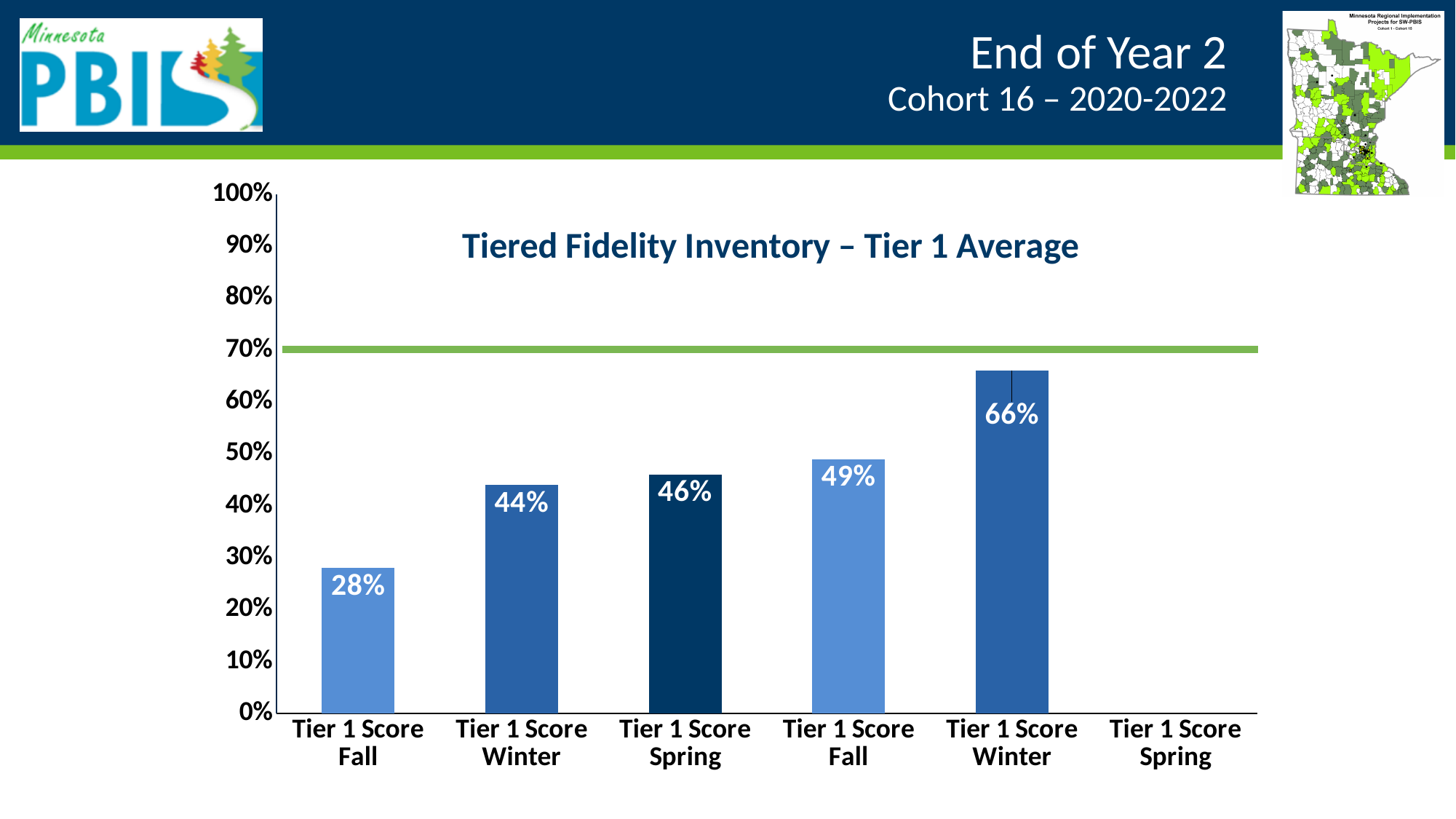
What is the title of the chart? Tiered Fidelity Inventory – Tier 1 Average What is the value of the first Tier 1 Score Spring bar (third bar from the left)? 46% What is the value of the second Tier 1 Score Winter bar (fifth bar from the left)? 66% What type of chart is shown on the slide? bar chart Which bar has the lowest value? The first Tier 1 Score Fall bar (28%) How many category labels are shown along the x axis? 6 Do the bar values rise or fall from left to right across the plotted bars? rise Which bar has the highest value? The second Tier 1 Score Winter bar (66%) What is the value of the first Tier 1 Score Fall bar (leftmost bar)? 28% What is the difference between the second Tier 1 Score Winter bar and the first Tier 1 Score Fall bar? 38% What is the value of the second Tier 1 Score Fall bar (fourth bar from the left)? 49% What is the value of the first Tier 1 Score Winter bar (second bar from the left)? 44%